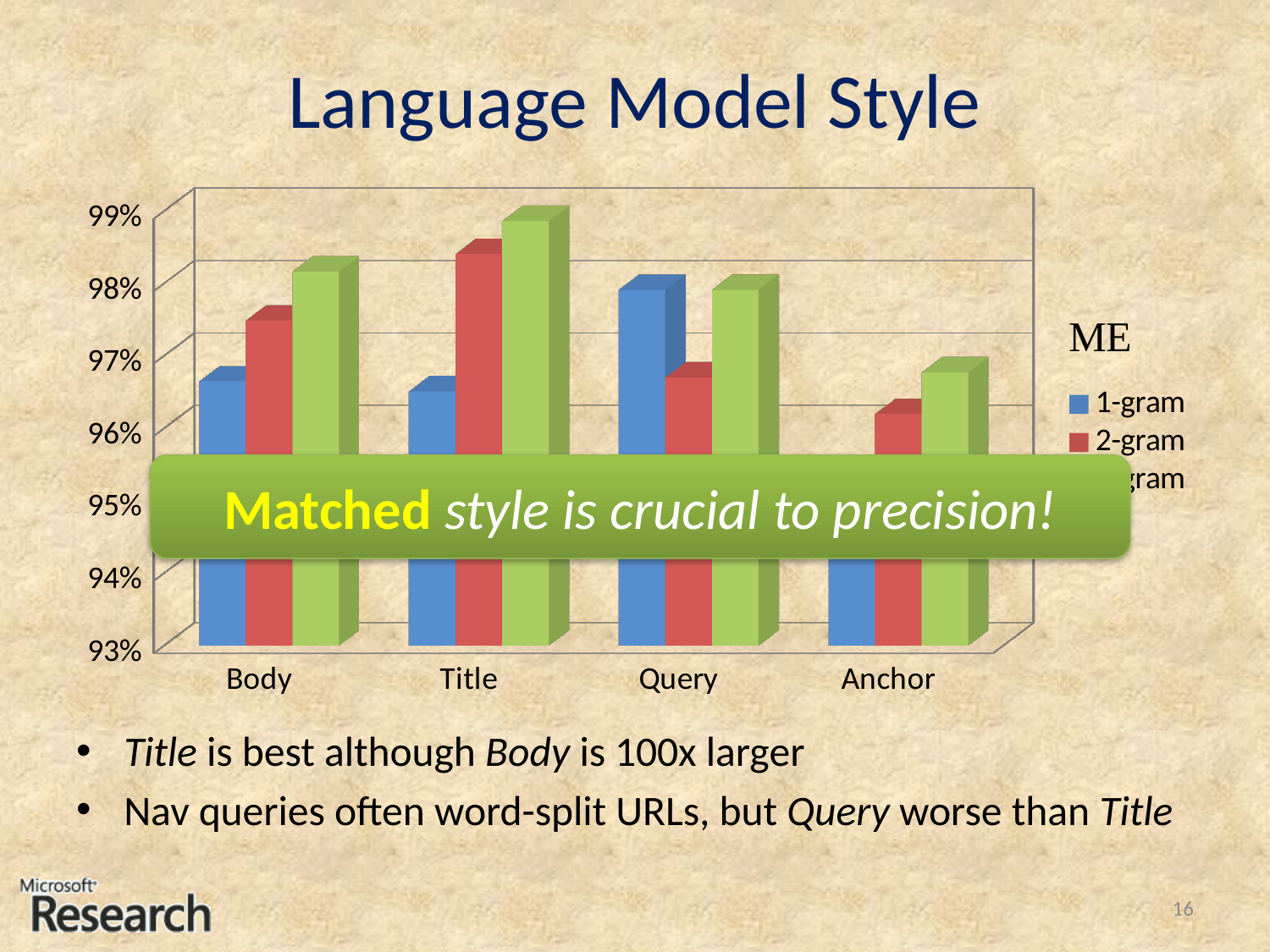
How many categories are shown on the x axis of the chart? 4 What kind of chart is shown on the slide? Bar chart Which category has the lowest value for the 2-gram series? Anchor Is the 2-gram value for Body greater or less than 97%? greater What is the title shown above the chart's legend? ME How many series does the chart's legend list? 3 Which category has the highest value for the 2-gram series? Title Is the 1-gram value for Body greater or less than 97%? less Is the 2-gram value for Anchor greater or less than 97%? less For the Body category, which is larger: the 1-gram value or the 2-gram value? 2-gram Which category has the highest value for the 1-gram series? Query For the Query category, which is larger: the 1-gram value or the 2-gram value? 1-gram